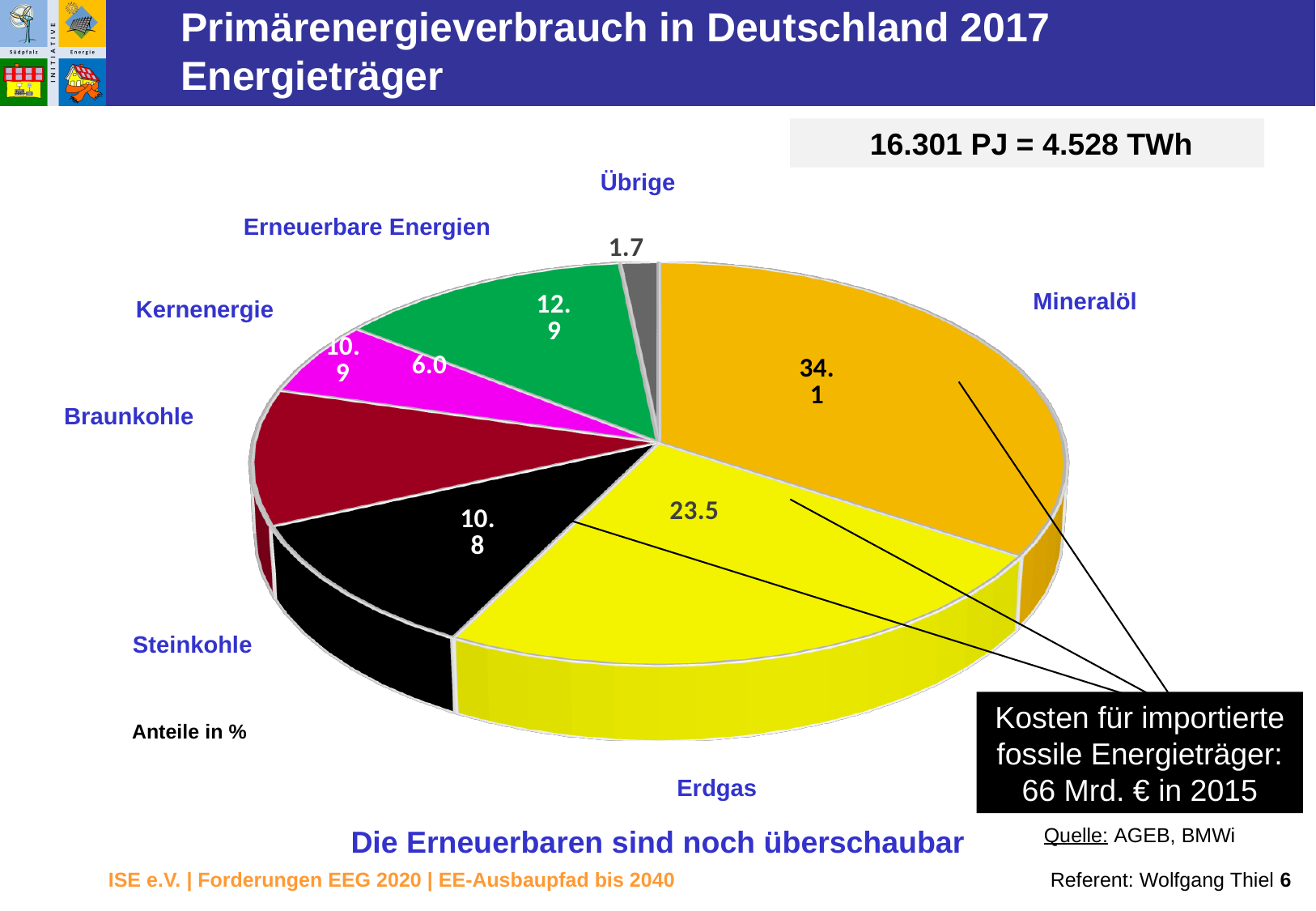
Which energy source has the smallest slice in the pie chart? Übrige What share does Kernenergie have in the pie chart? 6.0 What share does Steinkohle have in the pie chart? 10.8 Which energy source has the largest slice in the pie chart? Mineralöl What share does Mineralöl have in the pie chart? 34.1 Which slice is larger, Erneuerbare Energien or Steinkohle? Erneuerbare Energien What kind of chart is shown on the slide? pie chart How many energy source categories are shown in the pie chart? 7 What is the difference in percentage points between the Mineralöl and Erdgas slices? 10.6 What share does Übrige have in the pie chart? 1.7 What share does Erneuerbare Energien have in the pie chart? 12.9 What share does Erdgas have in the pie chart? 23.5